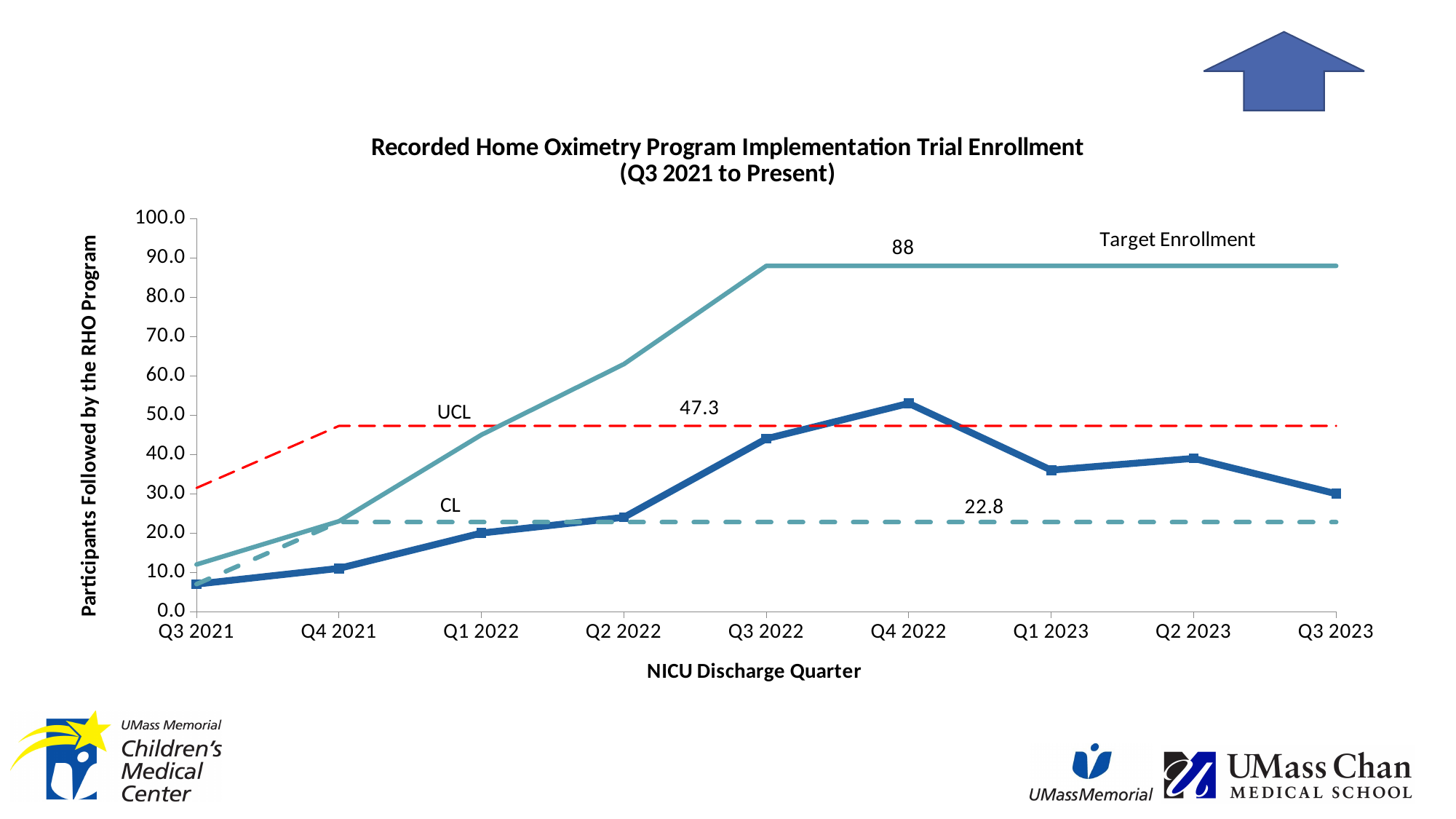
Does the dark blue enrollment line rise or fall from Q4 2022 to Q3 2023? Fall What is the value of the CL line? 22.8 Is the value of the dark blue enrollment line for Q3 2023 greater or less than 40? less How many quarters are shown along the x axis? 9 What is the difference between the UCL value and the CL value? 24.5 What is the value of the UCL line? 47.3 In which quarter is the dark blue enrollment line at its lowest? Q3 2021 In which quarter does the dark blue enrollment line reach its highest point? Q4 2022 What kind of chart is shown on the slide? Line chart What is the title of the chart? Recorded Home Oximetry Program Implementation Trial Enrollment (Q3 2021 to Present) What is the label of the x axis? NICU Discharge Quarter What value does the Target Enrollment line reach from Q3 2022 onward? 88